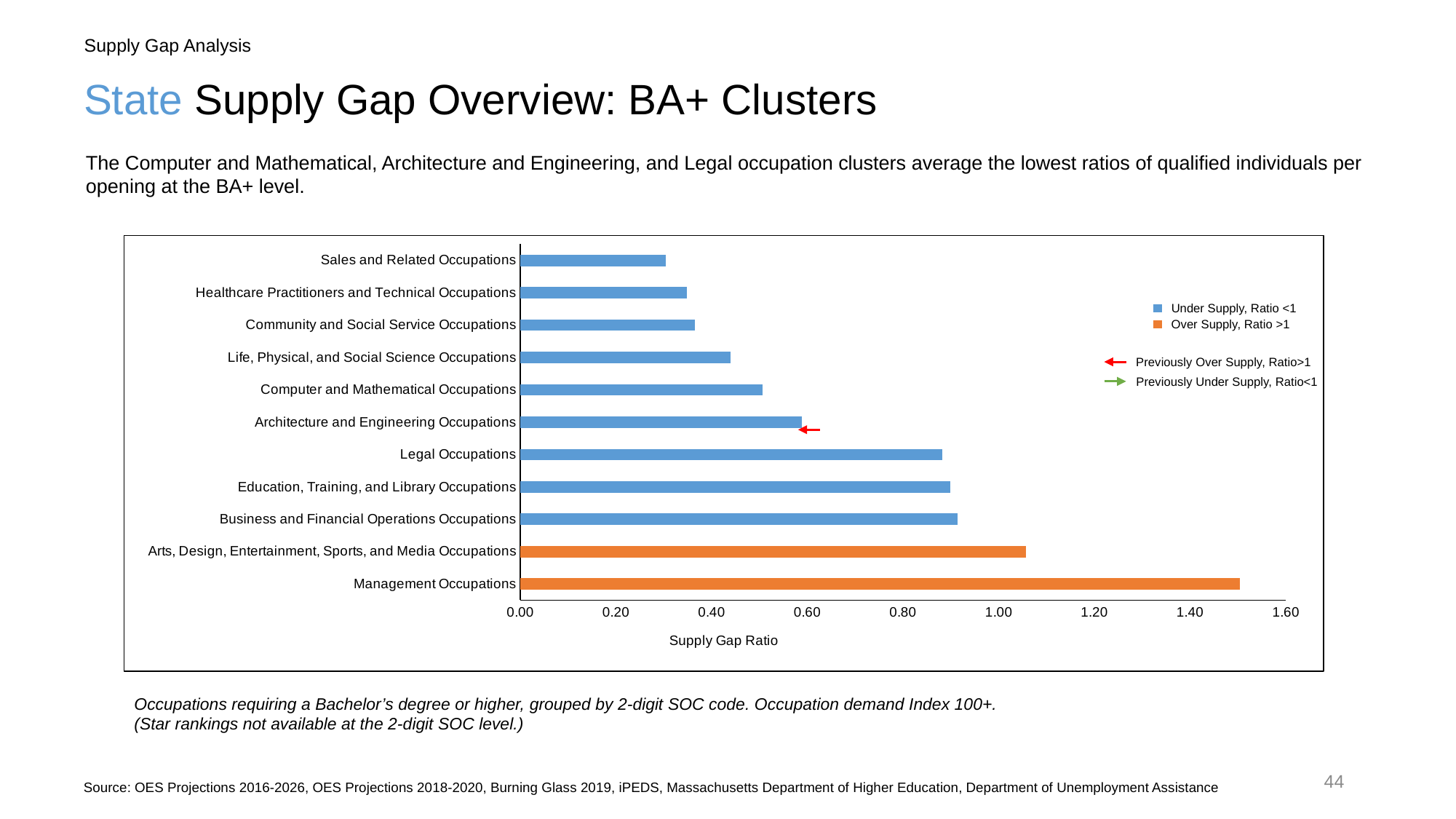
Is the supply gap ratio for Legal Occupations greater or less than 0.80? greater How many occupation clusters are plotted in the chart? 11 What is the title of the horizontal axis of the chart? Supply Gap Ratio How many coloured series does the chart legend list? 2 Is the supply gap ratio for Management Occupations greater or less than 1.40? greater Is the supply gap ratio for Business and Financial Operations Occupations greater or less than 1.00? less What kind of chart is shown on the slide? Bar chart Which occupation cluster has the lowest supply gap ratio? Sales and Related Occupations Which occupation cluster is marked with the red 'Previously Over Supply' arrow? Architecture and Engineering Occupations Which has the larger supply gap ratio: Legal Occupations or Computer and Mathematical Occupations? Legal Occupations Which occupation cluster has the highest supply gap ratio? Management Occupations